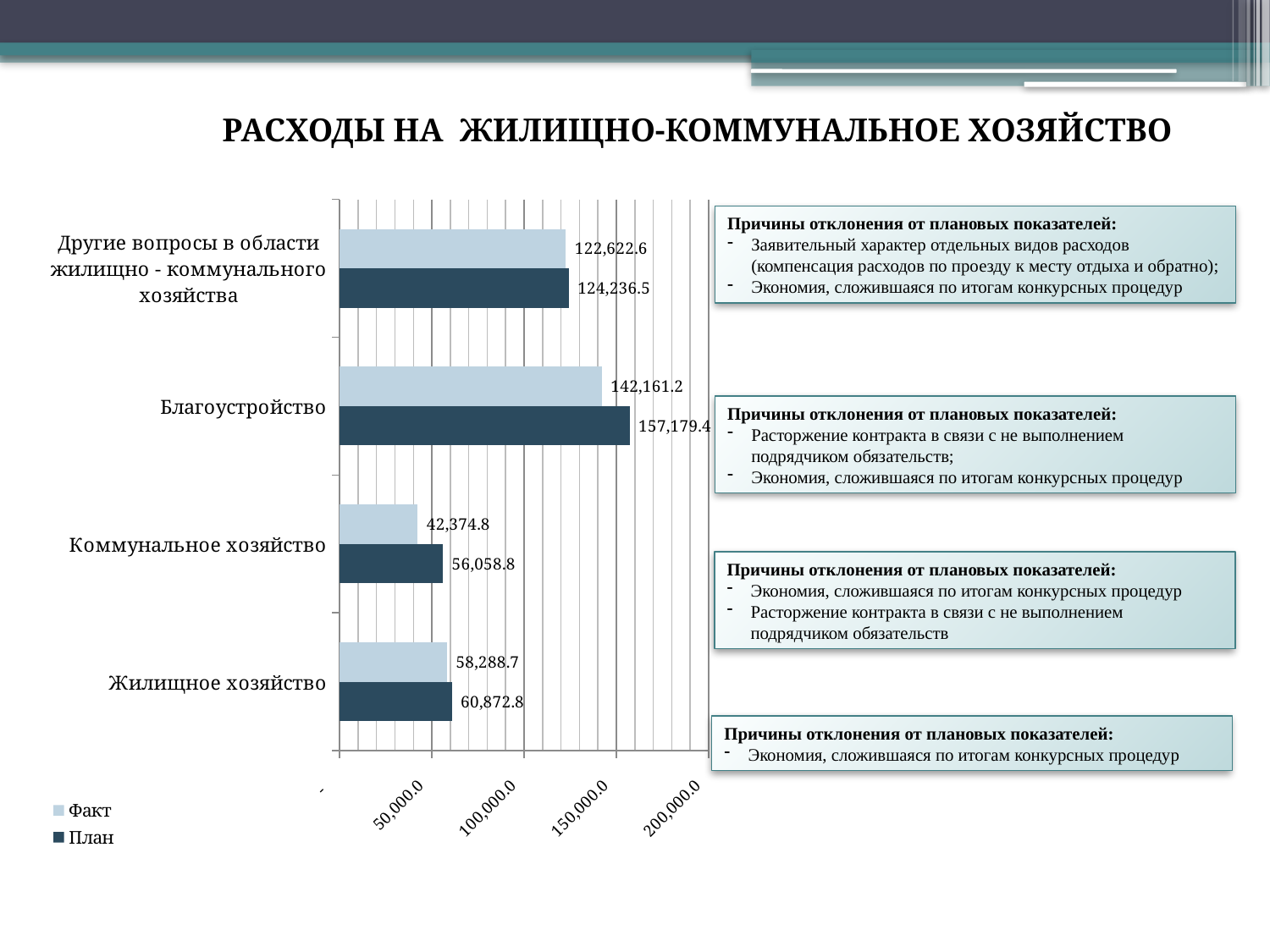
What is the План value for Коммунальное хозяйство? 56,058.8 What is the План value for Другие вопросы в области жилищно-коммунального хозяйства? 124,236.5 What is the Факт value for Благоустройство? 142,161.2 What is the difference between the План and Факт values for Благоустройство? 15,018.2 What is the difference between the План and Факт values for Коммунальное хозяйство? 13,684.0 What is the Факт value for Жилищное хозяйство? 58,288.7 How many categories are shown on the chart? 4 Which category has the highest План value? Благоустройство What type of chart is shown on the slide? Bar chart Which is larger for Жилищное хозяйство, the Факт value or the План value? План How many series does the legend list? 2 Which category has the lowest Факт value? Коммунальное хозяйство